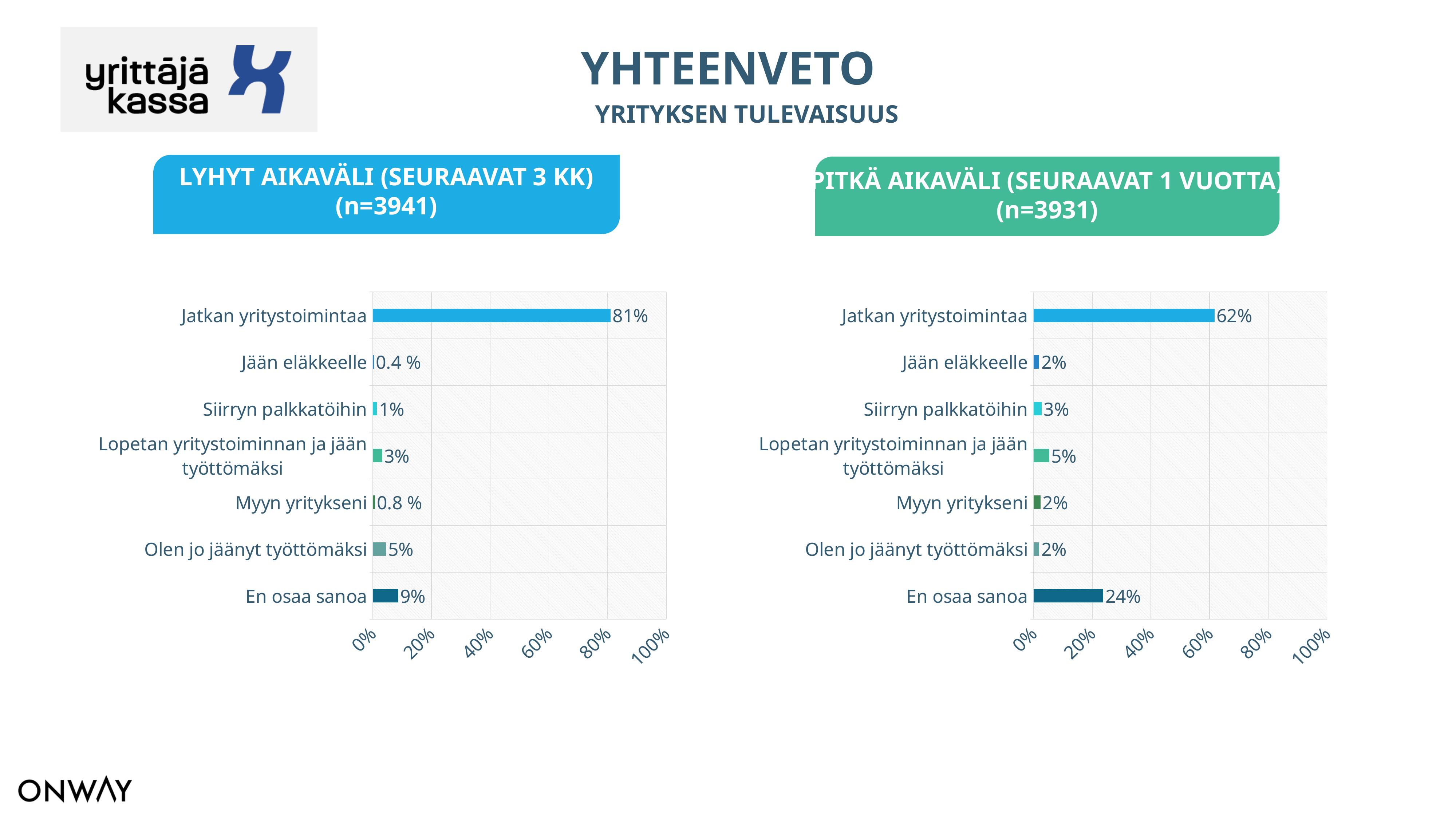
In the right chart (Pitkä aikaväli), is the value for Jatkan yritystoimintaa greater or less than 60%? greater In the left chart (Lyhyt aikaväli), which is larger: Olen jo jäänyt työttömäksi or Lopetan yritystoiminnan ja jään työttömäksi? Olen jo jäänyt työttömäksi How many categories are shown in the left chart (Lyhyt aikaväli)? 7 In the left chart (Lyhyt aikaväli), which category has the highest value? Jatkan yritystoimintaa In the left chart (Lyhyt aikaväli), which category has the lowest value? Jään eläkkeelle What kind of chart is used on the right side of the slide (Pitkä aikaväli)? Bar chart In the right chart (Pitkä aikaväli), what is the value for Lopetan yritystoiminnan ja jään työttömäksi? 5% What is the difference between the Jatkan yritystoimintaa values in the left chart (81%) and the right chart (62%)? 19 percentage points In the left chart (Lyhyt aikaväli), what is the value for Jään eläkkeelle? 0.4 % In the right chart (Pitkä aikaväli, seuraavat 1 vuotta), what is the value for En osaa sanoa? 24% In the left chart (Lyhyt aikaväli, seuraavat 3 kk), what is the value for Jatkan yritystoimintaa? 81% In the right chart (Pitkä aikaväli), which category has the highest value? Jatkan yritystoimintaa